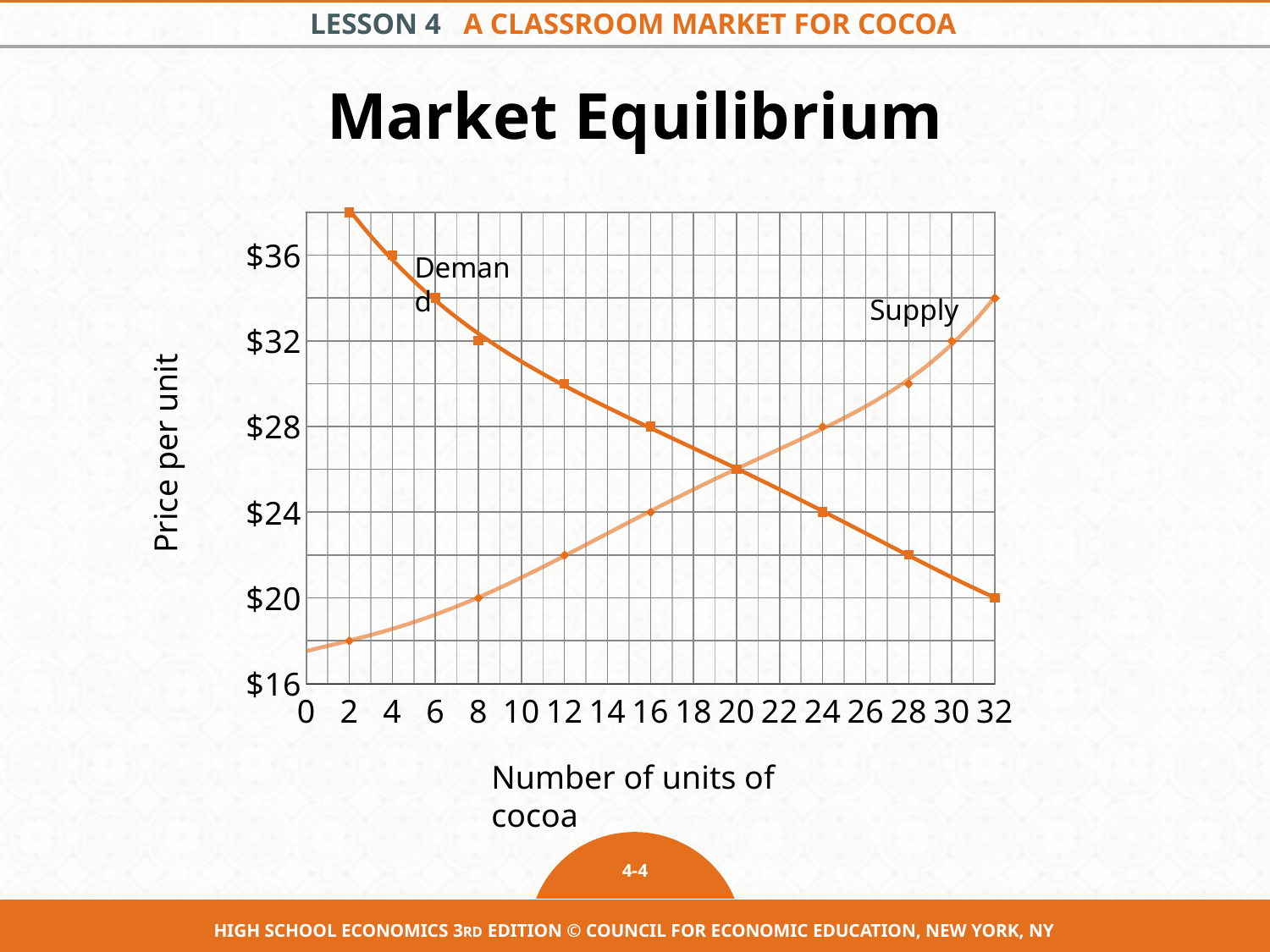
What is the label of the vertical axis? Price per unit Is the price where the Demand and Supply curves cross greater or less than $28? less At which number of units is the Supply price lowest? 2 What is the price on the Supply curve at 8 units of cocoa? $20 How many series are plotted on the chart? 2 What is the price on the Supply curve at 24 units of cocoa? $28 At 8 units of cocoa, how much higher is the Demand price than the Supply price? $12 What kind of chart is shown on the slide? line chart What is the price on the Demand curve at 8 units of cocoa? $32 Does the Demand curve rise or fall as the number of units of cocoa increases? fall What is the price on the Demand curve at 32 units of cocoa? $20 At 28 units of cocoa, which curve shows the higher price, Demand or Supply? Supply